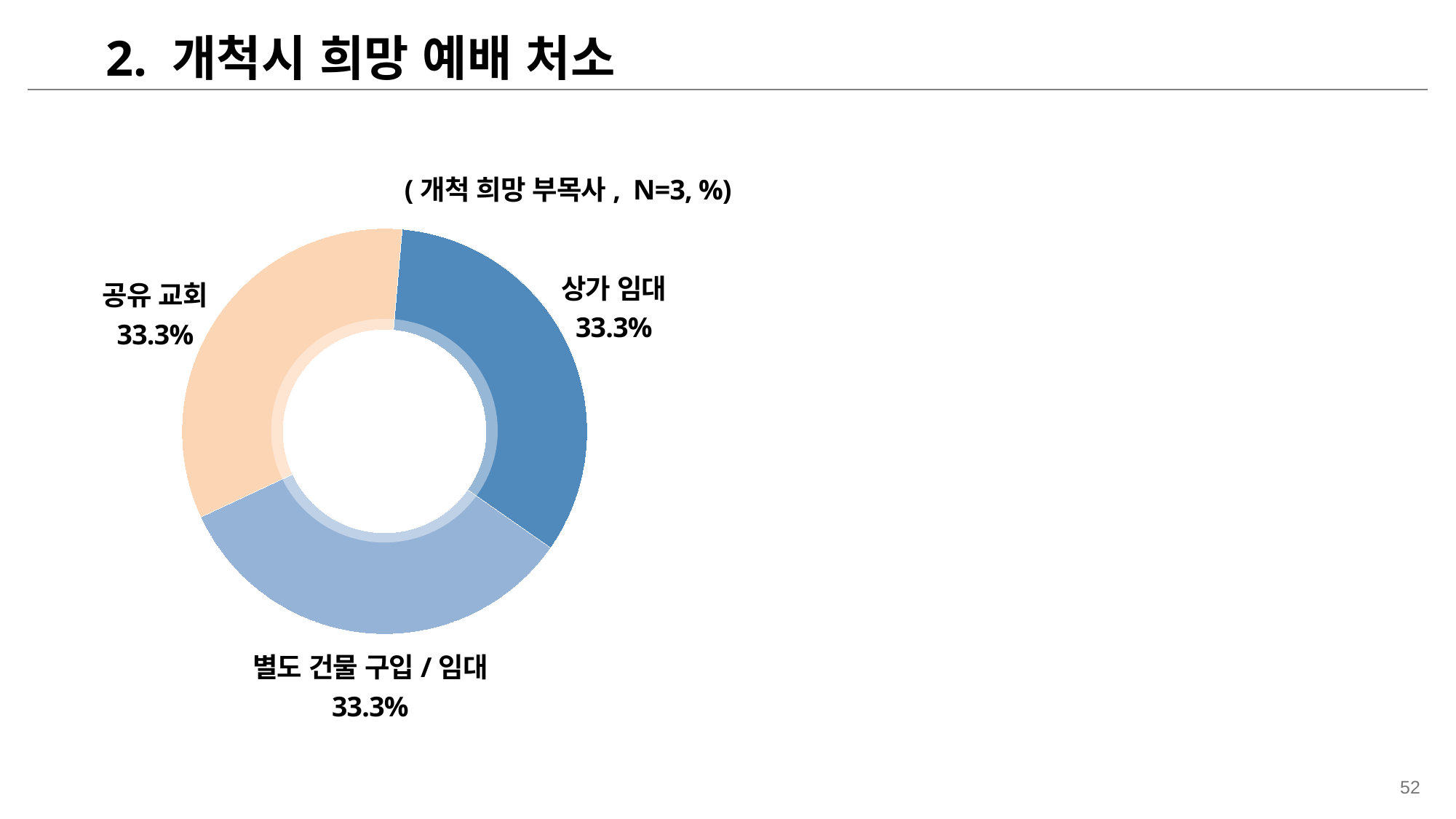
How many categories are shown in the chart? 3 What is the sample size (N) stated in the chart subtitle? N=3 What is the value for 상가 임대? 33.3% What kind of chart is shown on the slide? Donut (pie) chart What is the difference between the values for 상가 임대 and 공유 교회? 0.0% Do all three slices of the chart have the same value? Yes What is the title of the slide? 2. 개척시 희망 예배 처소 What is the value for 공유 교회? 33.3% What is the value for 별도 건물 구입 / 임대? 33.3% What share of the chart does the 별도 건물 구입 / 임대 slice represent? 33.3%